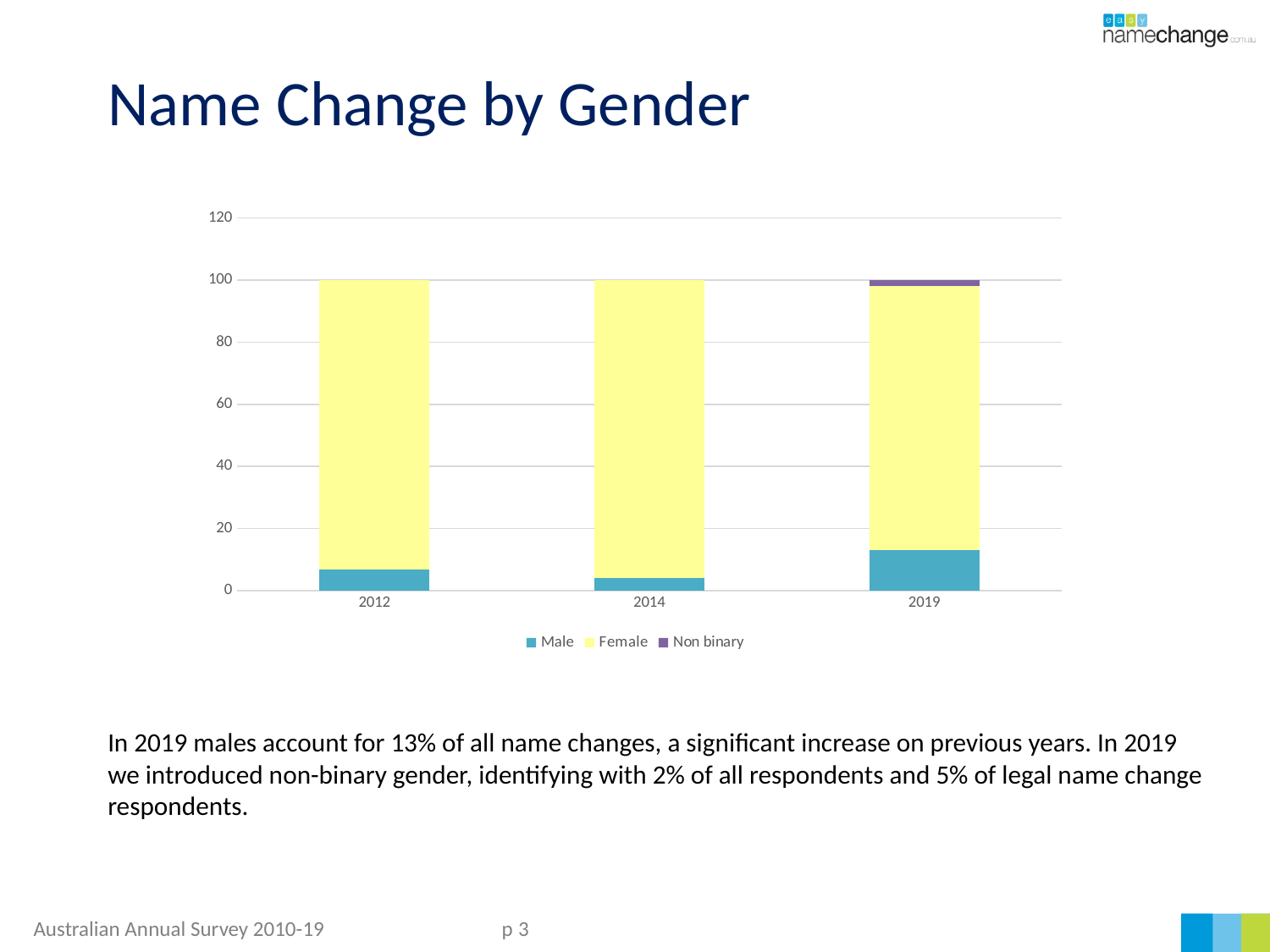
Which year has the largest Male segment? 2019 Is the Female value for 2014 greater or less than 80? greater What kind of chart is shown on the slide? Stacked bar chart How many series does the legend list? 3 Which year has the smallest Male segment? 2014 Is the Male value for 2019 greater or less than 20? less Which year is the only one with a Non binary segment? 2019 Which is larger, the Male segment for 2019 or the Male segment for 2014? 2019 How many years are shown on the x axis? 3 What is the total height of the stacked bar for 2012? 100 Which series is shown in yellow? Female Is the Male value for 2012 greater or less than 20? less